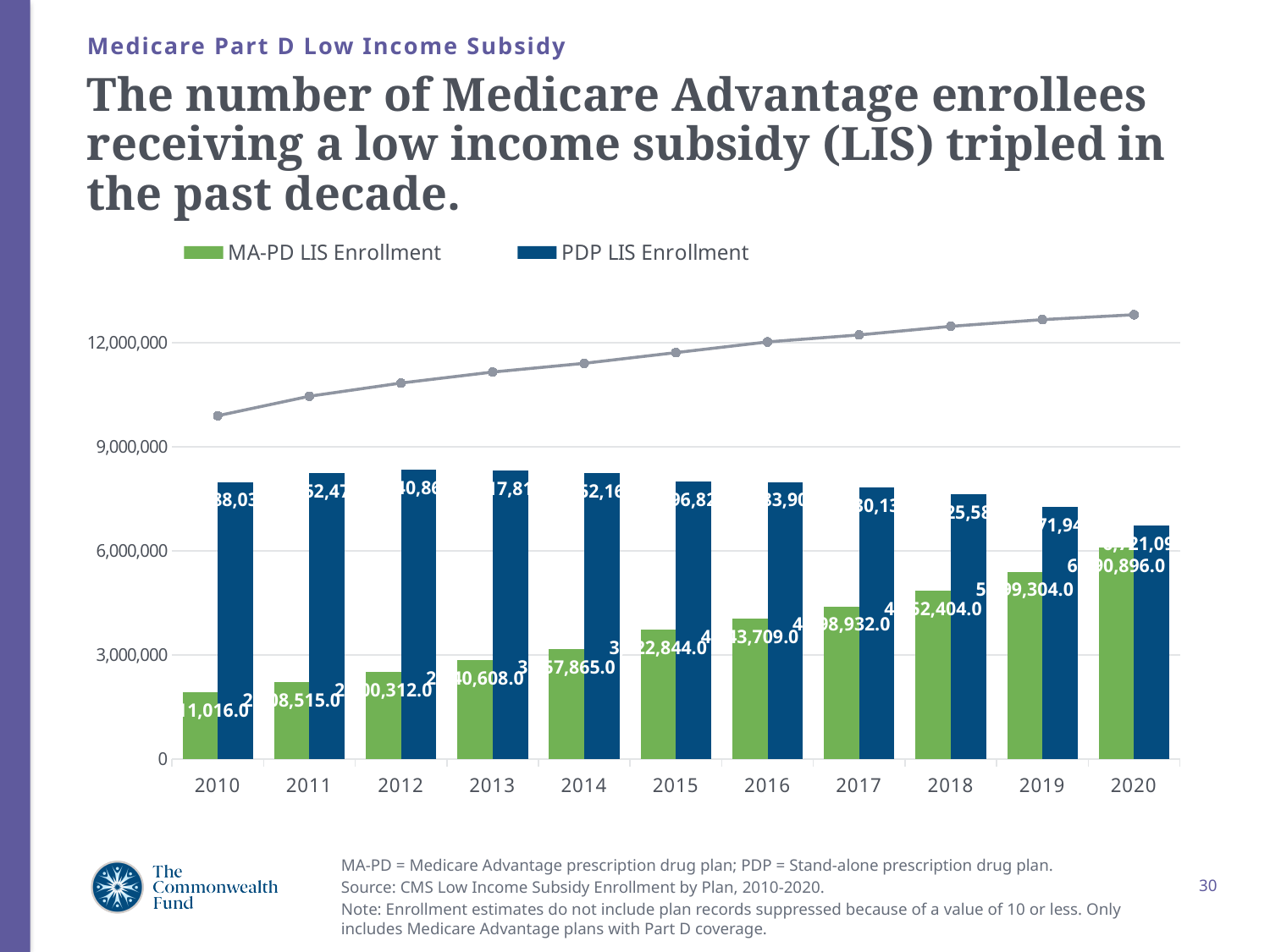
How many years are shown on the x axis? 11 Is the MA-PD LIS Enrollment for 2010 greater or less than 3,000,000? less Does MA-PD LIS Enrollment rise or fall from 2010 to 2020? rise In 2010, which is larger: MA-PD LIS Enrollment or PDP LIS Enrollment? PDP LIS Enrollment Which year has the lowest PDP LIS Enrollment? 2020 Does PDP LIS Enrollment rise or fall from 2013 to 2020? fall Which year has the lowest MA-PD LIS Enrollment? 2010 How many series does the legend list? 2 Which year has the highest MA-PD LIS Enrollment? 2020 Which colour represents PDP LIS Enrollment in the legend? dark blue What kind of chart is shown on the slide? combination bar and line chart Is the PDP LIS Enrollment for 2012 greater or less than 6,000,000? greater